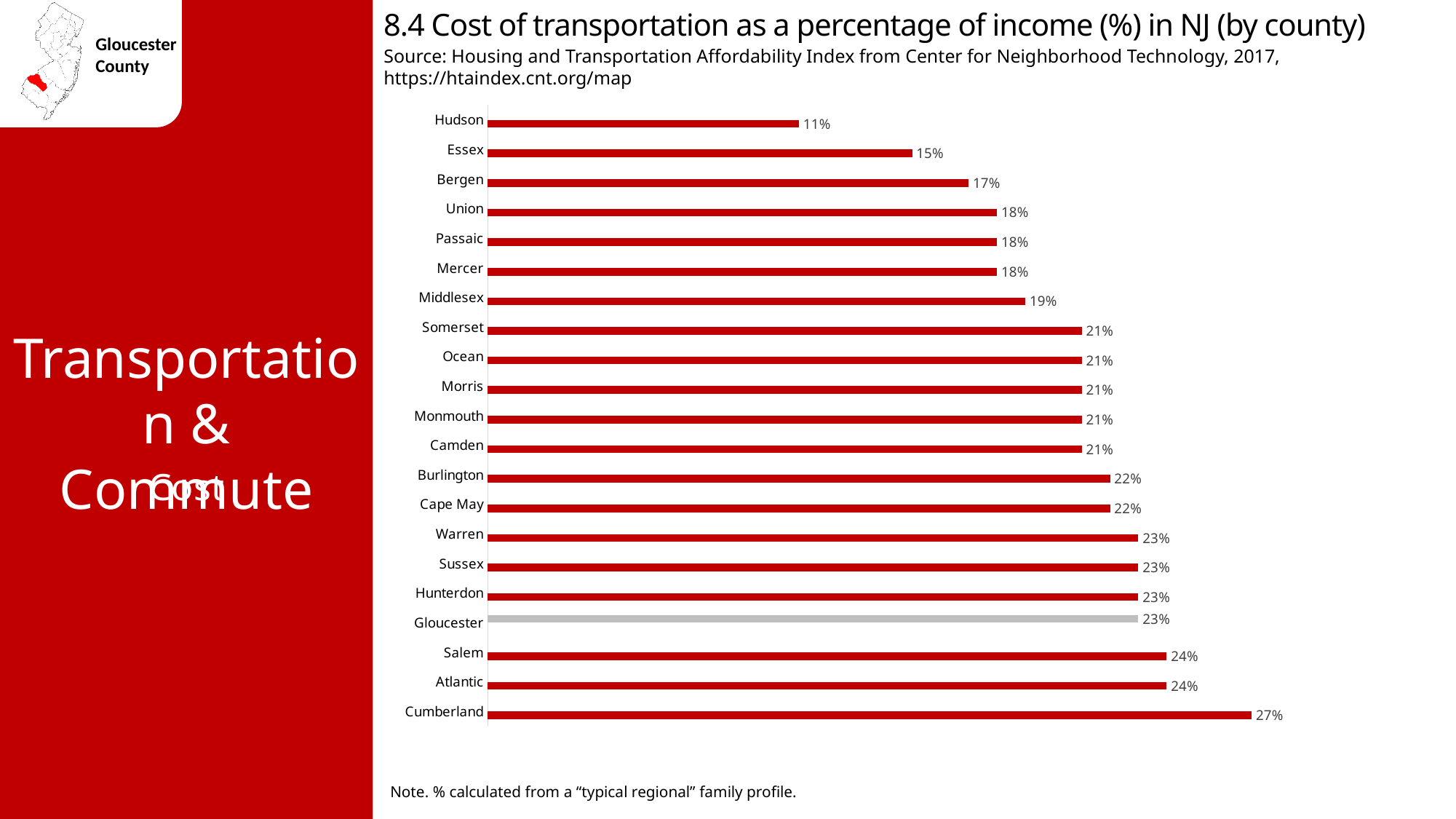
Which has a higher value, Bergen or Salem? Salem How many counties are shown in the chart? 21 What type of chart is shown on the slide? Bar chart What is the value shown for Middlesex County? 19% What is the difference between the values for Gloucester and Essex? 8% What is the cost of transportation as a percentage of income for Gloucester County? 23% Which county has the highest cost of transportation as a percentage of income? Cumberland Which county has the lowest cost of transportation as a percentage of income? Hudson What is the value shown for Hudson County? 11% What is the difference between the values for Cumberland and Hudson? 16% Which county's bar is shown in gray rather than red? Gloucester Which has a higher value, Atlantic or Somerset? Atlantic